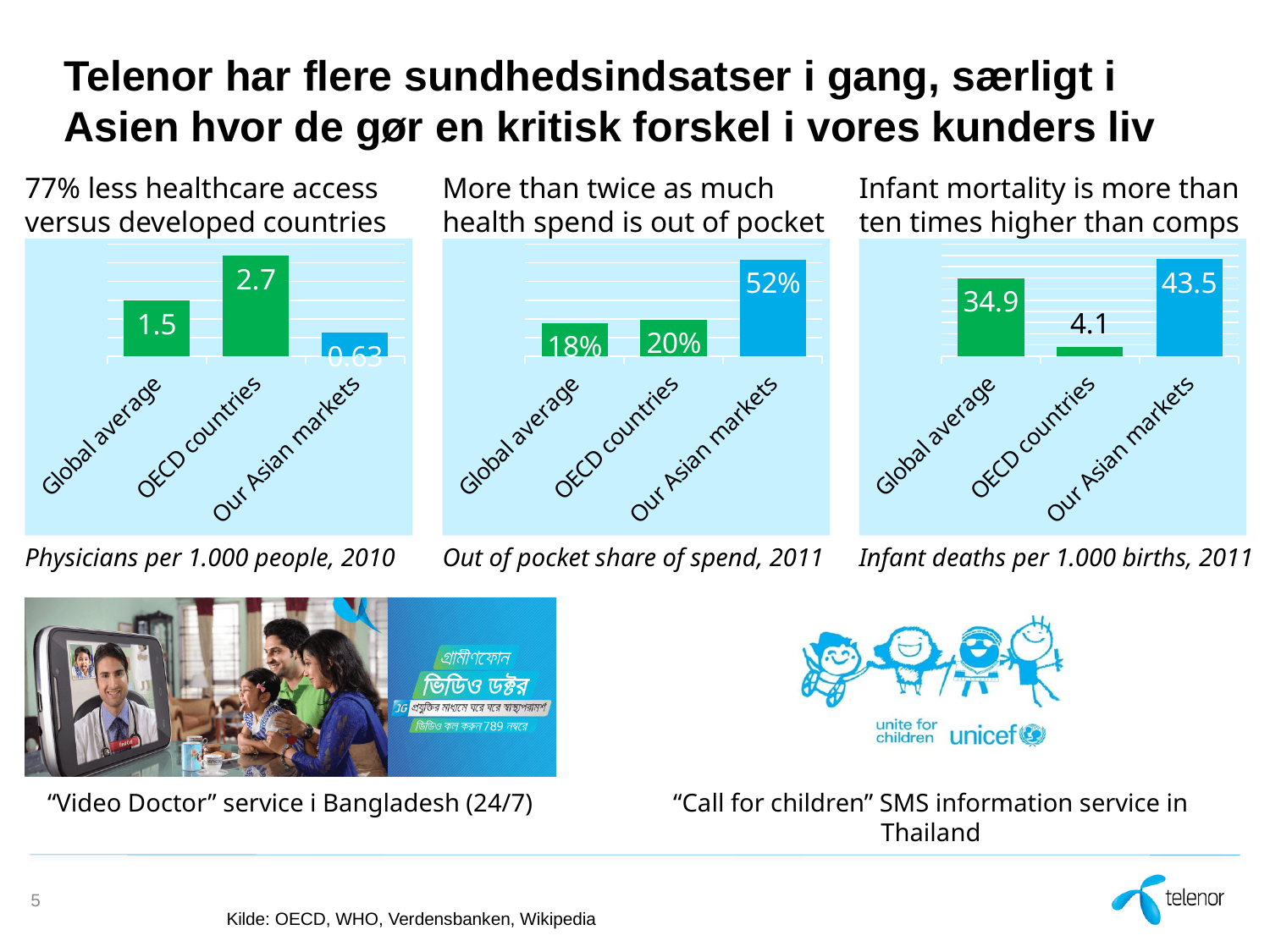
In the middle chart (Out of pocket share of spend, 2011), which category has the highest value? Our Asian markets In the left chart (Physicians per 1.000 people, 2010), which category has the lowest value? Our Asian markets In the left chart (Physicians per 1.000 people, 2010), what is the value for OECD countries? 2.7 What type of chart is the right chart (Infant deaths per 1.000 births, 2011)? Bar chart In the right chart (Infant deaths per 1.000 births, 2011), which category has the lowest value? OECD countries In the right chart (Infant deaths per 1.000 births, 2011), which is larger: Global average or Our Asian markets? Our Asian markets In the middle chart (Out of pocket share of spend, 2011), what is the value for Our Asian markets? 52% In the left chart (Physicians per 1.000 people, 2010), what is the value for Our Asian markets? 0.63 How many categories are shown in the middle chart (Out of pocket share of spend, 2011)? 3 In the right chart (Infant deaths per 1.000 births, 2011), what is the value for Global average? 34.9 In the middle chart (Out of pocket share of spend, 2011), what is the difference between Our Asian markets and OECD countries? 32% In the left chart (Physicians per 1.000 people, 2010), what is the difference between OECD countries and Global average? 1.2